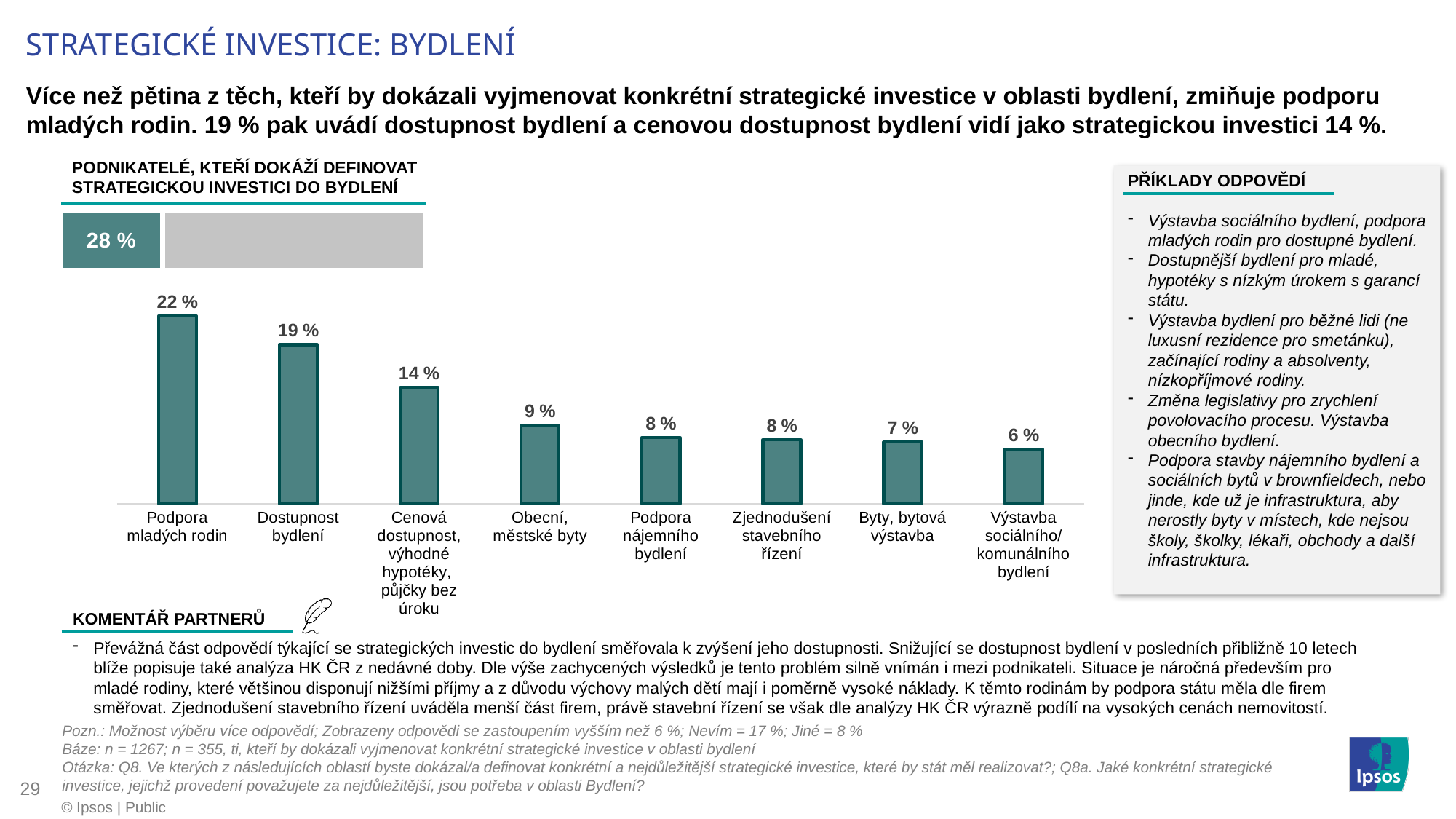
What kind of chart is the main chart on the slide? Bar chart In the main bar chart, what is the value for Obecní, městské byty? 9 % In the main bar chart, what is the value for Podpora mladých rodin? 22 % In the small bar titled 'Podnikatelé, kteří dokáží definovat strategickou investici do bydlení', what value is shown? 28 % How many categories does the main bar chart show? 8 In the main bar chart, which category has the lowest value? Výstavba sociálního/komunálního bydlení In the main bar chart, which is larger: Cenová dostupnost, výhodné hypotéky, půjčky bez úroku or Obecní, městské byty? Cenová dostupnost, výhodné hypotéky, půjčky bez úroku In the main bar chart, what is the value for Byty, bytová výstavba? 7 % In the main bar chart, do the values rise or fall from left to right? Fall In the main bar chart, what is the difference between Podpora mladých rodin and Dostupnost bydlení? 3 % In the main bar chart, what is the value for Dostupnost bydlení? 19 % In the main bar chart, which category has the highest value? Podpora mladých rodin